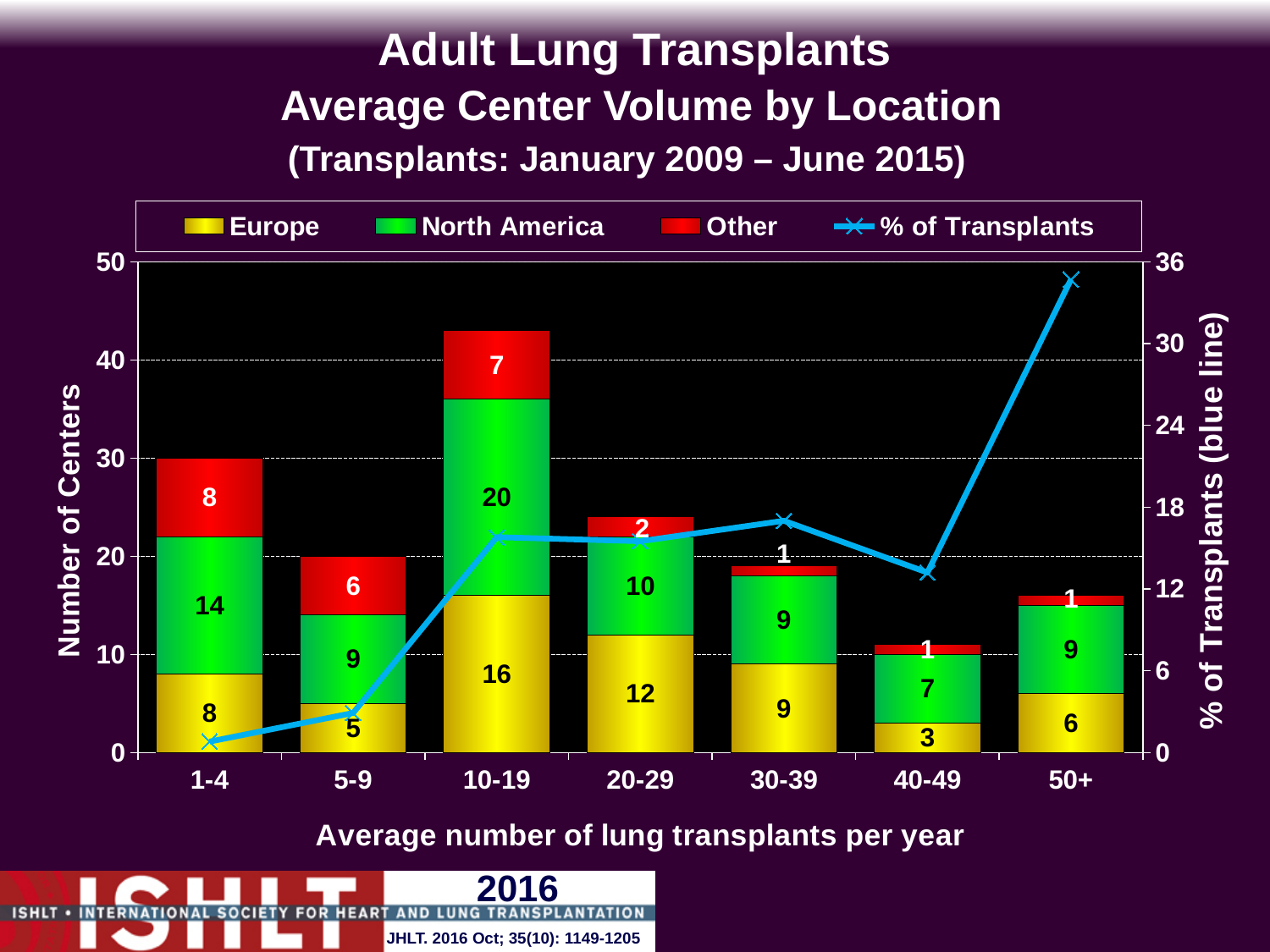
How many categories are shown on the x axis? 7 How many centers in Europe have an average of 10-19 lung transplants per year? 16 Is the % of Transplants value for the 50+ category greater or less than 30? greater In the 20-29 category, which is larger: the Europe value or the North America value? Europe Which category has the highest number of Europe centers? 10-19 What is the difference between the North America values for the 10-19 and 20-29 categories? 10 What is the value for Other in the 5-9 category? 6 What is the number of North America centers in the 1-4 category? 14 What is the total number of centers in the 10-19 category (all three regions combined)? 43 What is the total height of the stacked bar for the 1-4 category? 30 How many series does the legend list? 4 Which category has the lowest number of Europe centers? 40-49